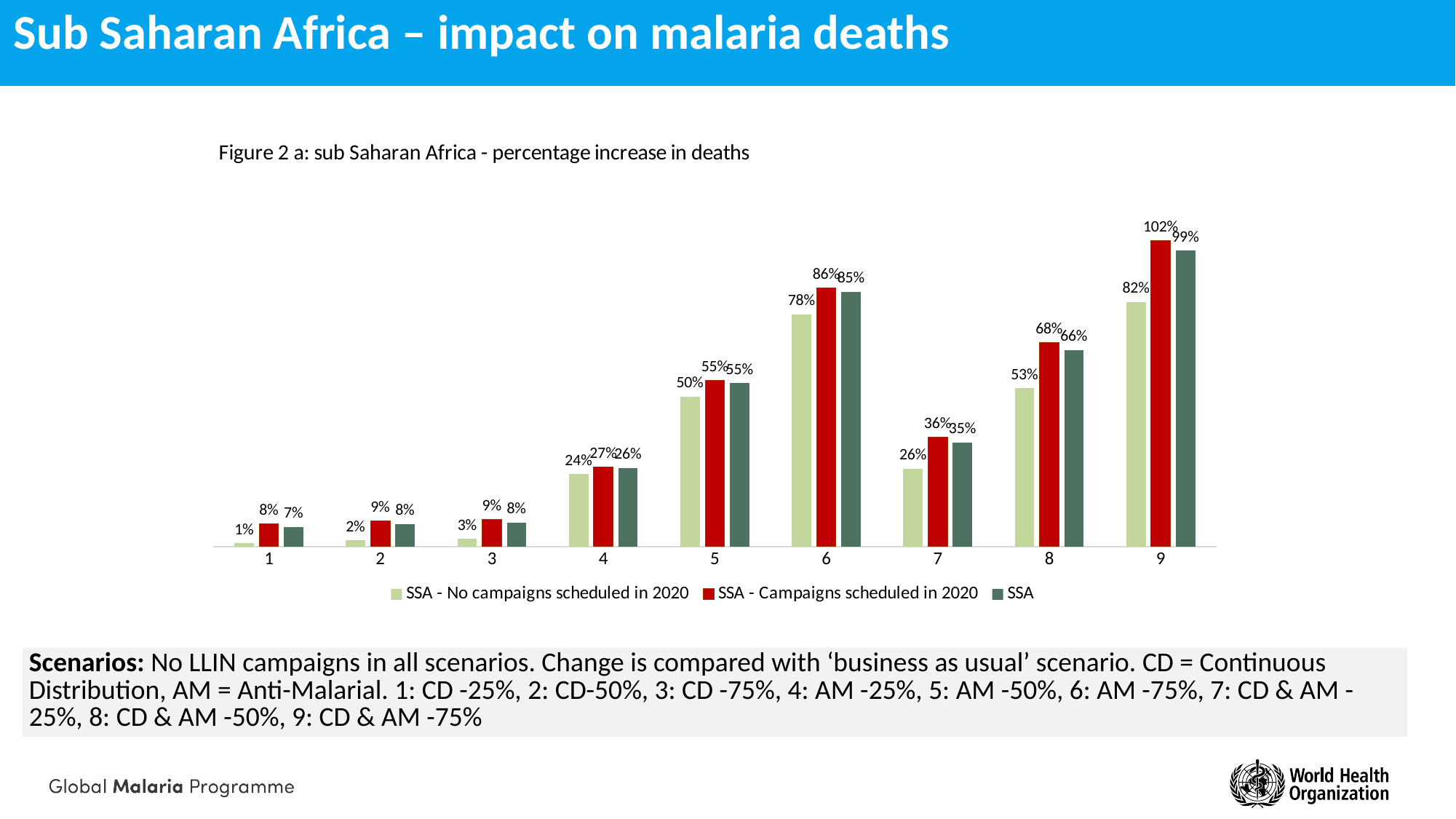
For scenario 7, which is larger: the 'SSA - Campaigns scheduled in 2020' value or the 'SSA - No campaigns scheduled in 2020' value? SSA - Campaigns scheduled in 2020 How many scenarios are shown on the x axis? 9 What kind of chart is shown on the slide? Bar chart What is the value for scenario 4 in the 'SSA' series? 26% What is the title of the chart? Figure 2 a: sub Saharan Africa - percentage increase in deaths What is the value for scenario 6 in the 'SSA - No campaigns scheduled in 2020' series? 78% What is the difference between the 'SSA - Campaigns scheduled in 2020' and 'SSA - No campaigns scheduled in 2020' values for scenario 8? 15% Which scenario has the lowest value in the 'SSA - No campaigns scheduled in 2020' series? 1 Which scenario has the highest value in the 'SSA' series? 9 Which series is shown in red? SSA - Campaigns scheduled in 2020 What is the value for scenario 9 in the 'SSA - Campaigns scheduled in 2020' series? 102% How many series does the legend list? 3